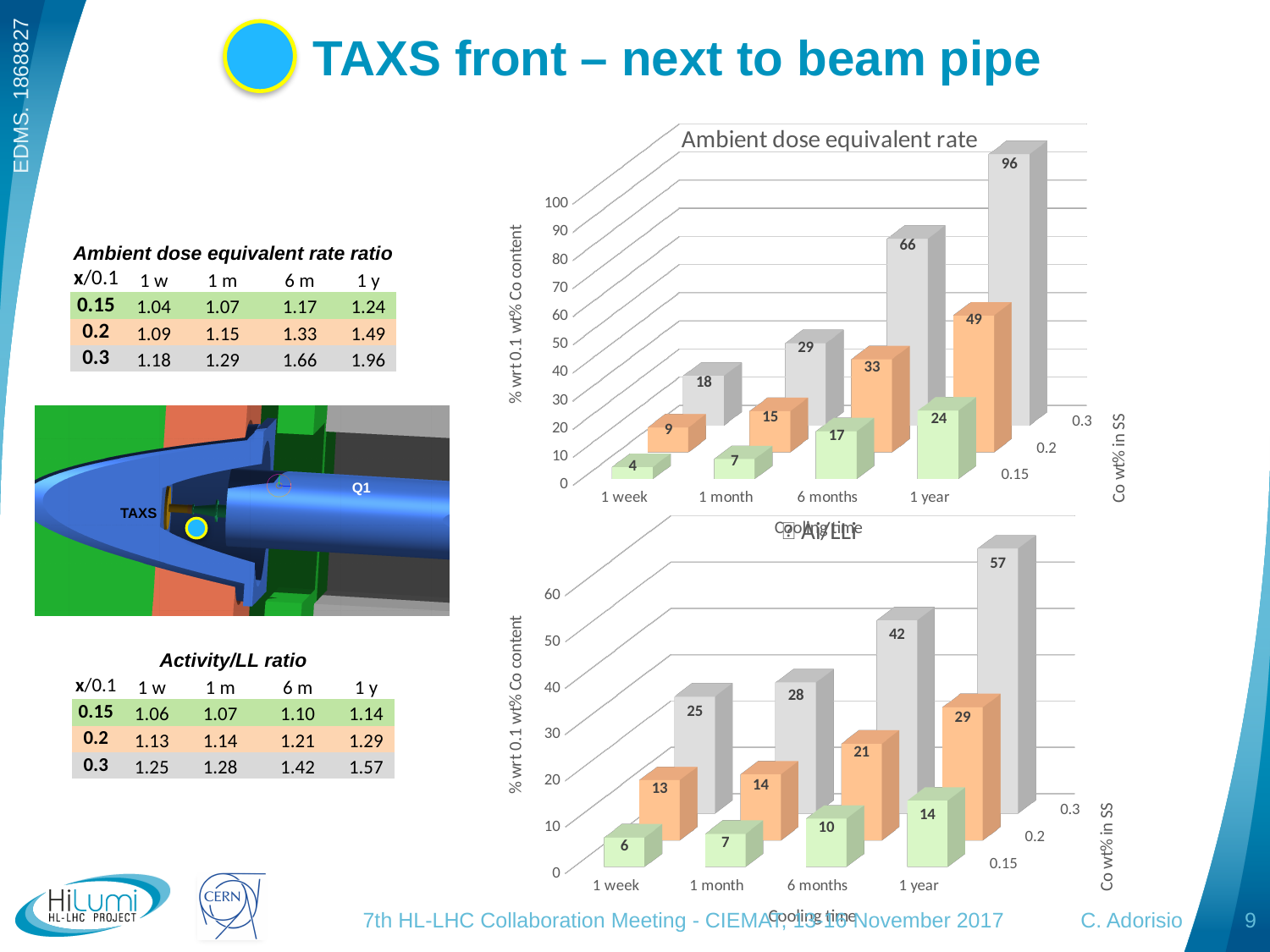
In the top chart titled "Ambient dose equivalent rate", what is the difference between the 0.3 and 0.15 values at 1 year? 72 In the lower chart on the right, what is the value for 0.15 Co wt% in SS at 1 week? 6 In the lower chart on the right, which is larger: the 0.2 value at 6 months or the 0.3 value at 1 week? 0.3 value at 1 week In the top chart titled "Ambient dose equivalent rate", which cooling time has the highest value for the 0.3 series? 1 year In the lower chart on the right, what is the difference between the 0.3 value at 1 year and the 0.3 value at 6 months? 15 In the top chart titled "Ambient dose equivalent rate", what is the value for 0.2 Co wt% in SS at 1 month? 15 In the top chart titled "Ambient dose equivalent rate", how many cooling-time categories are shown on the x axis? 4 In the lower chart on the right, what is the value for 0.3 Co wt% in SS at 1 year? 57 In the top chart titled "Ambient dose equivalent rate", what is the value for 0.15 Co wt% in SS at 6 months? 17 What kind of chart is the top chart titled "Ambient dose equivalent rate"? bar chart In the top chart titled "Ambient dose equivalent rate", what is the value for 0.3 Co wt% in SS at 1 year? 96 In the top chart titled "Ambient dose equivalent rate", do the values for the 0.2 series rise or fall from 1 week to 1 year? rise